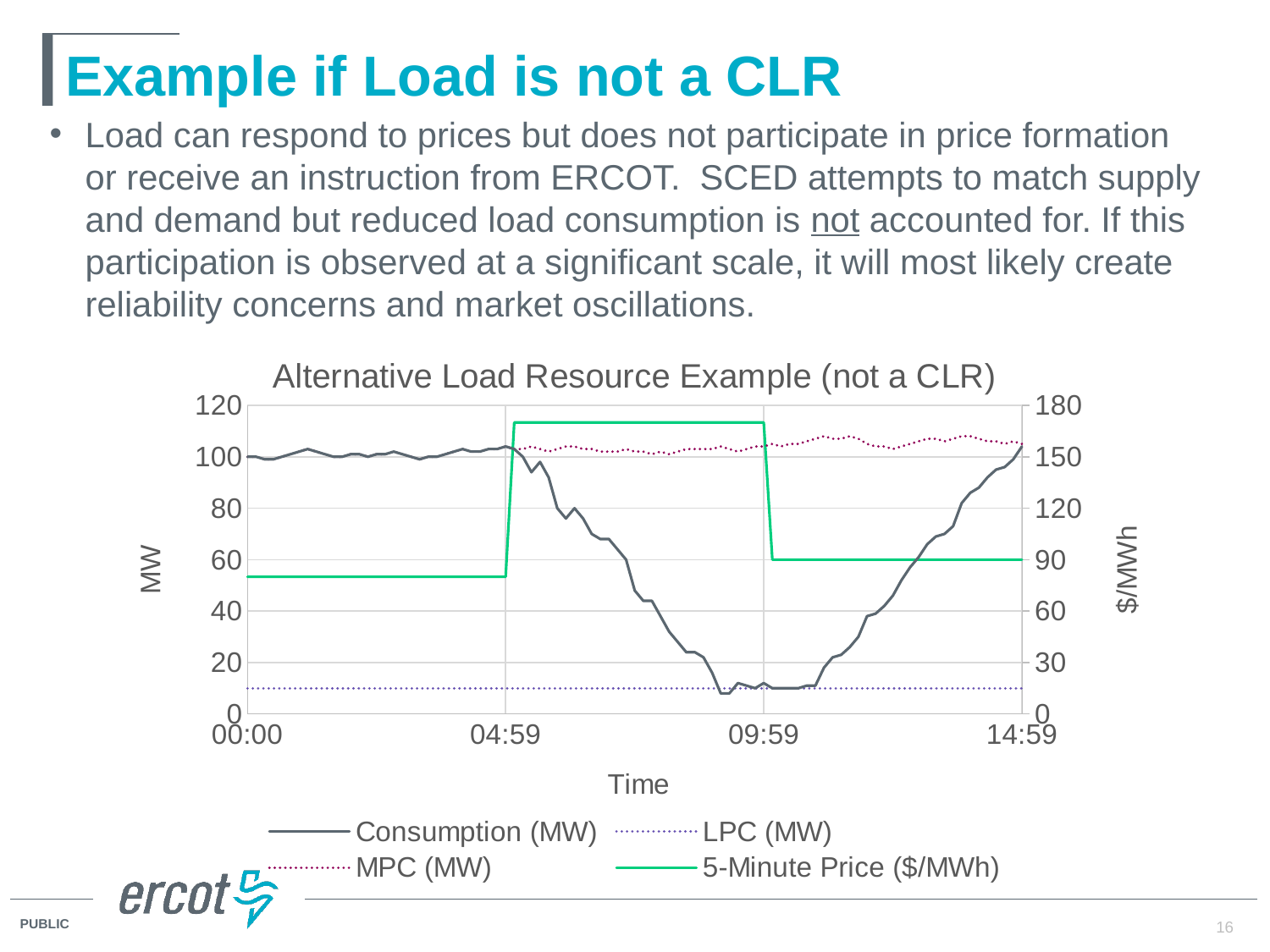
Is the 5-Minute Price between 04:59 and 09:59 greater or less than 150 $/MWh? greater Is the LPC (MW) line greater or less than 20 MW? less Is the Consumption (MW) value at 00:00 greater or less than 80 MW? greater Does Consumption (MW) rise or fall between 04:59 and 09:59? fall What is the title of the chart? Alternative Load Resource Example (not a CLR) What kind of chart is shown on the slide? line chart Does Consumption (MW) rise or fall between 09:59 and 14:59? rise How many series does the legend list? 4 At 00:00, which is larger: Consumption (MW) or LPC (MW)? Consumption (MW) What is the label of the right-hand vertical axis? $/MWh